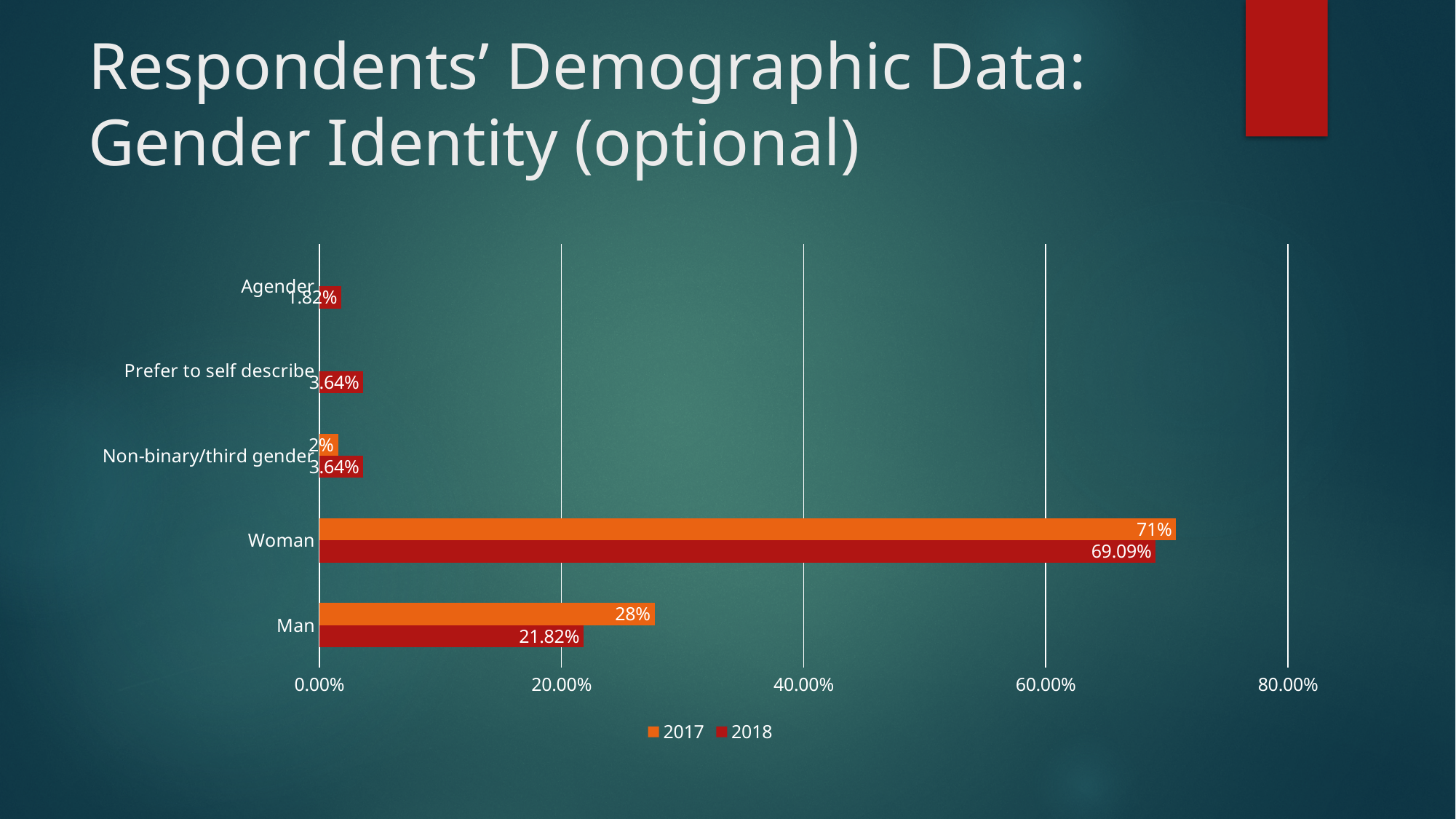
What is the 2017 value for Man? 28% What is the 2018 value for Woman? 69.09% What is the 2018 value for Agender? 1.82% What is the 2017 value for Non-binary/third gender? 2% Which category has the highest 2018 value? Woman Which category has the lowest 2018 value? Agender What kind of chart is shown on the slide? Bar chart What is the 2018 value for Man? 21.82% Is the 2017 value for Woman greater or less than 60.00%? greater Which is larger, the 2017 value for Woman or the 2018 value for Woman? 2017 How many series does the legend list? 2 What is the difference between the 2017 and 2018 values for Man? 6.18%